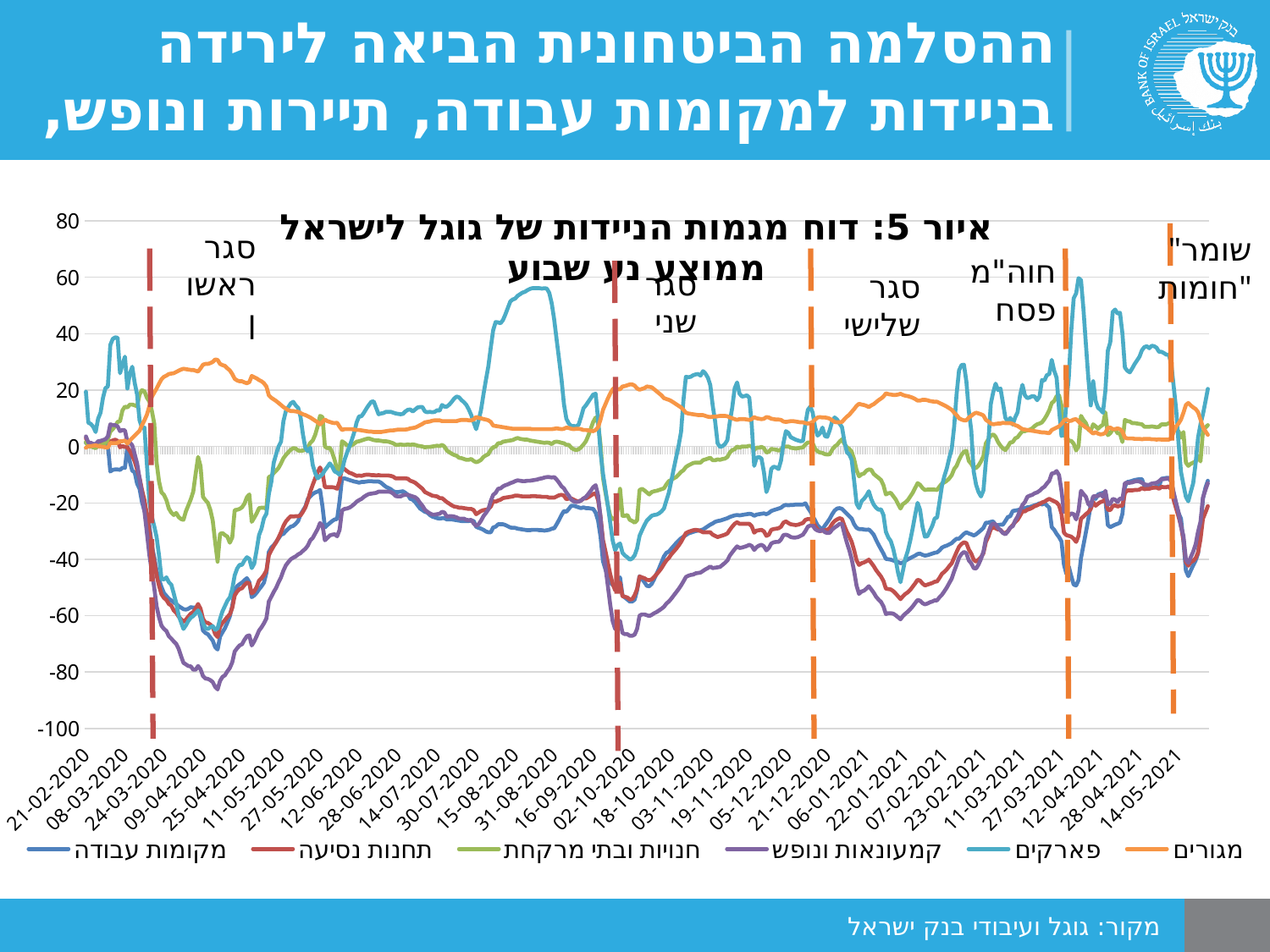
Is the value of the מגורים series around 25-04-2020 greater or less than 20? greater How many series does the legend list? 6 Is the peak of the פארקים series around 15-08-2020 greater or less than 40? greater What kind of chart is shown on the slide? line chart Which series reaches the lowest value on the chart? קמעונאות ונופש What is the first date label on the x axis? 21-02-2020 Around 25-04-2020, which series is higher: מגורים or מקומות עבודה? מגורים How many vertical dashed marker lines are drawn on the chart? 5 Which series reaches the highest value on the chart? פארקים What is the title of the chart? איור 5: דוח מגמות הניידות של גוגל לישראל ממוצע נע שבוע Is the lowest value of the קמעונאות ונופש series (around 25-04-2020) greater or less than -80? less Which series is drawn in orange according to the legend? מגורים